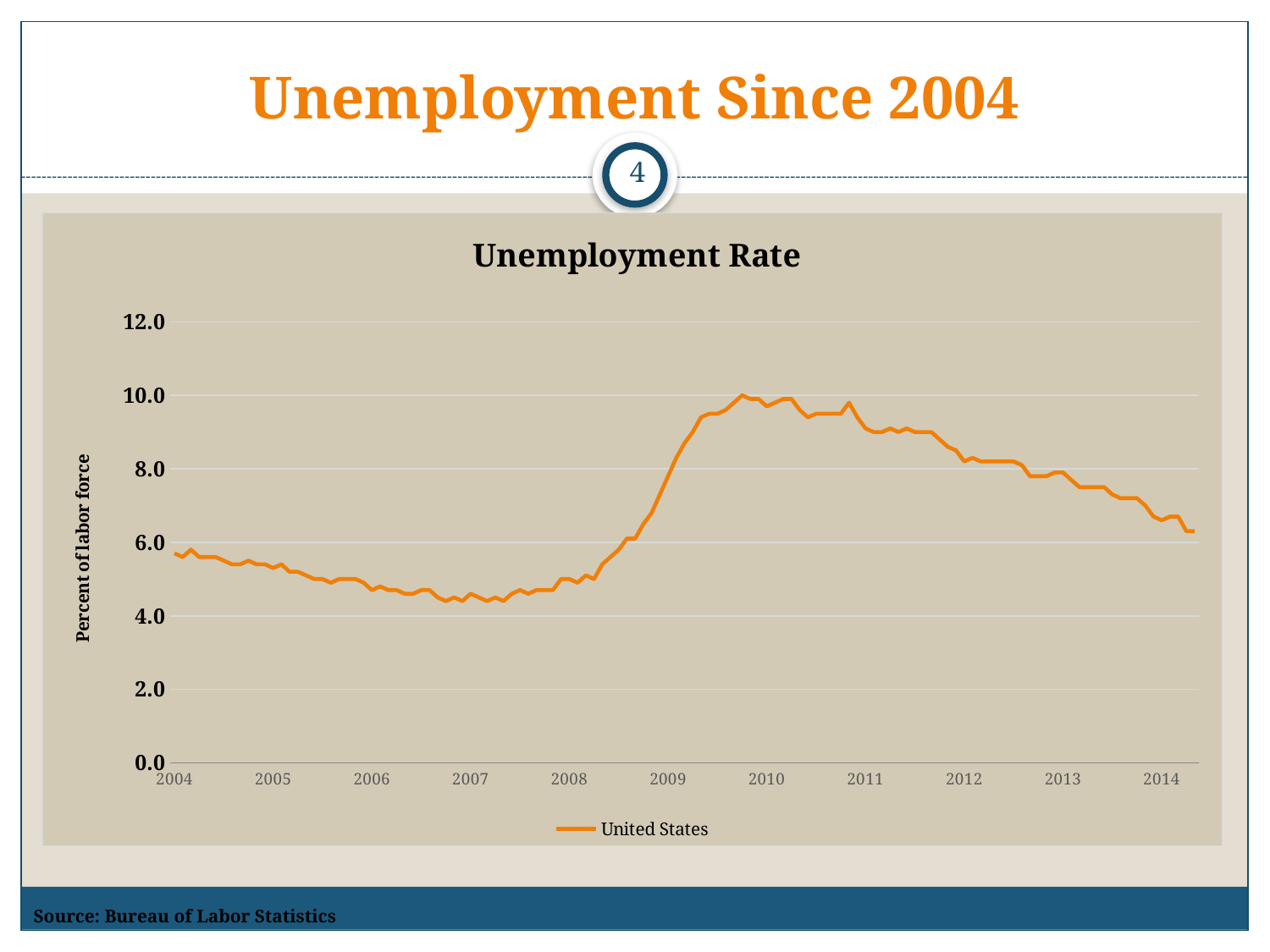
What kind of chart is shown on the slide? line chart Which is larger, the unemployment rate at the start of 2012 or at the start of 2006? 2012 Is the value for the United States at the start of 2010 greater or less than 8.0? greater Is the value for the United States at the start of 2007 greater or less than 6.0? less How many series does the legend list? 1 How many years are labeled on the x axis? 11 What is the title of the chart? Unemployment Rate What is the label on the vertical axis of the chart? Percent of labor force Does the unemployment rate rise or fall between 2008 and 2009? rise Is the value for the United States at the start of 2014 greater or less than 8.0? less Does the unemployment rate rise or fall between 2011 and 2014? fall